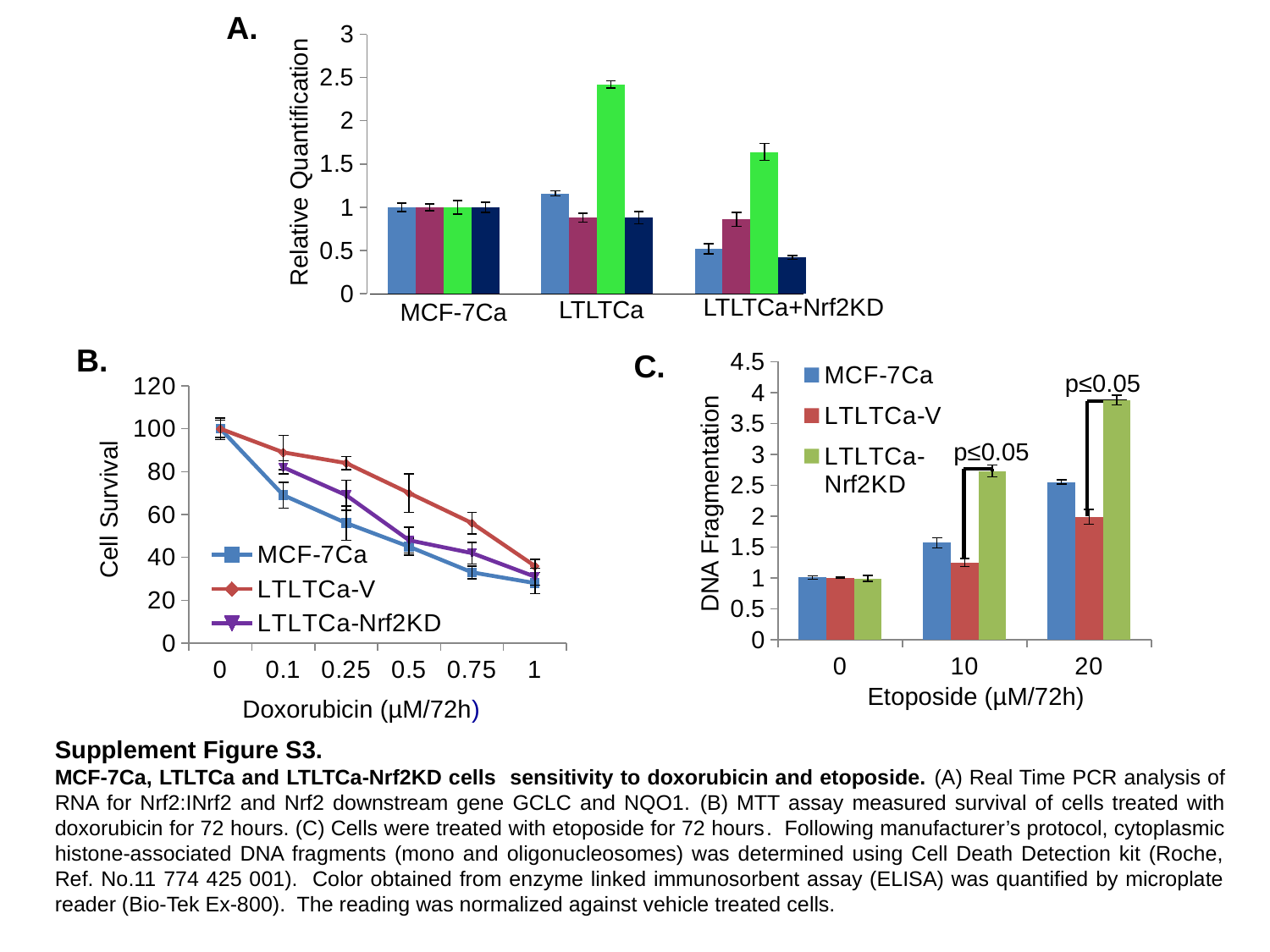
In chart B, which series has the highest Cell Survival at doxorubicin 0.5? LTLTCa-V What kind of chart is chart B? line chart In chart B, is the Cell Survival for MCF-7Ca at doxorubicin 1 greater or less than 40? less How many categories are shown on the x axis of chart A? 3 In chart A, is the tallest bar for LTLTCa greater or less than 2? greater In chart B, do the Cell Survival values rise or fall as the doxorubicin concentration increases? fall In chart C, is the DNA Fragmentation for LTLTCa-V at etoposide 10 greater or less than 1.5? less In chart A, which category contains the tallest bar? LTLTCa How many series does the legend of chart B list? 3 What kind of chart is chart A? bar chart In chart C, how many etoposide concentrations are shown on the x axis? 3 In chart C, which series has the highest DNA Fragmentation at etoposide 20? LTLTCa-Nrf2KD